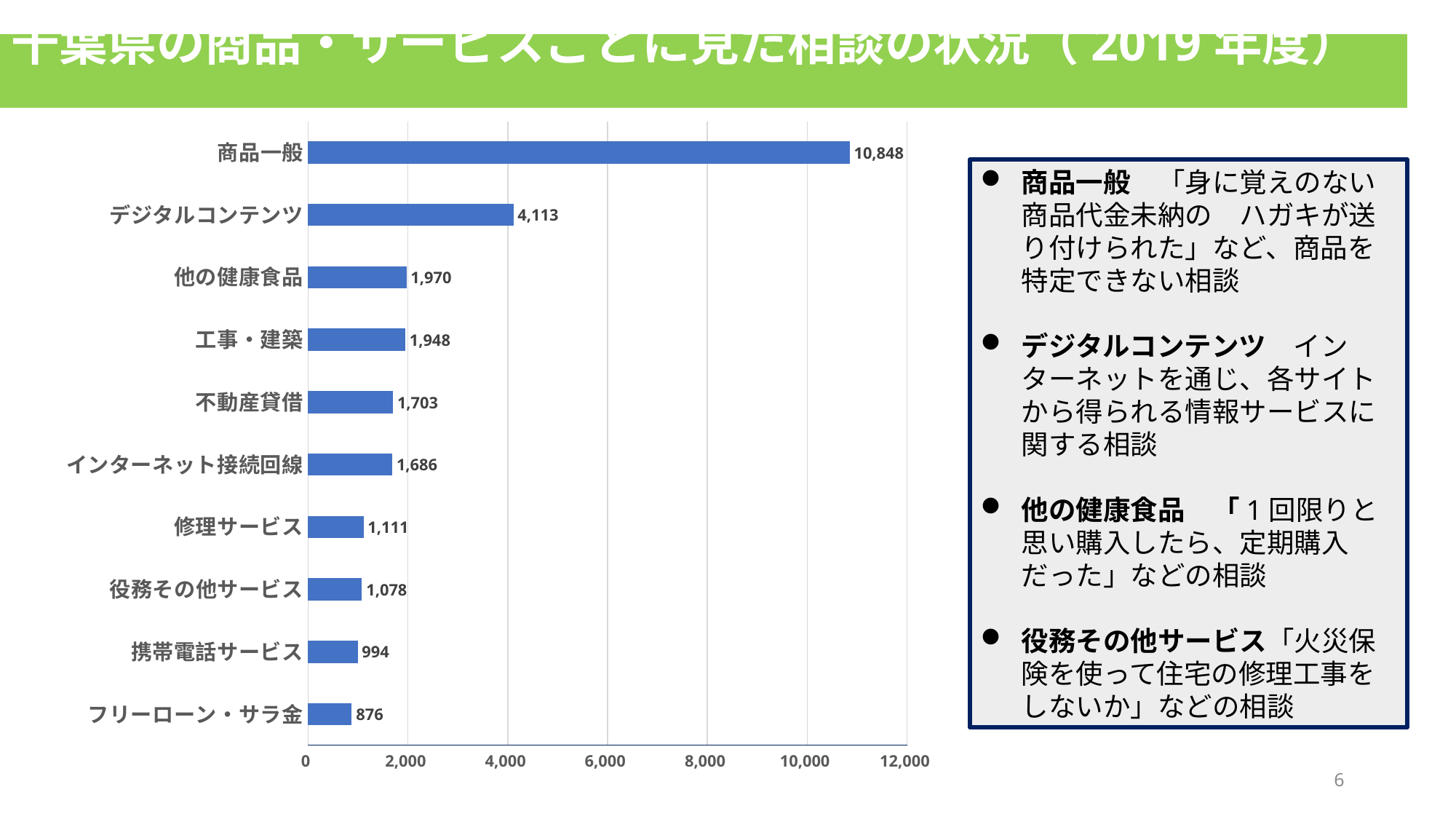
What is the value for 不動産貸借? 1,703 Which category has the highest value? 商品一般 Is the value for インターネット接続回線 greater or less than 2,000? less What is the value for デジタルコンテンツ? 4,113 What kind of chart is shown on the slide? bar chart What is the value for 商品一般? 10,848 What is the difference between the values for 他の健康食品 and 工事・建築? 22 How many categories are shown in the chart? 10 Which category has the lowest value? フリーローン・サラ金 What is the value for 携帯電話サービス? 994 Which is larger, the value for 修理サービス or the value for 役務その他サービス? 修理サービス What is the difference between the values for 商品一般 and デジタルコンテンツ? 6,735